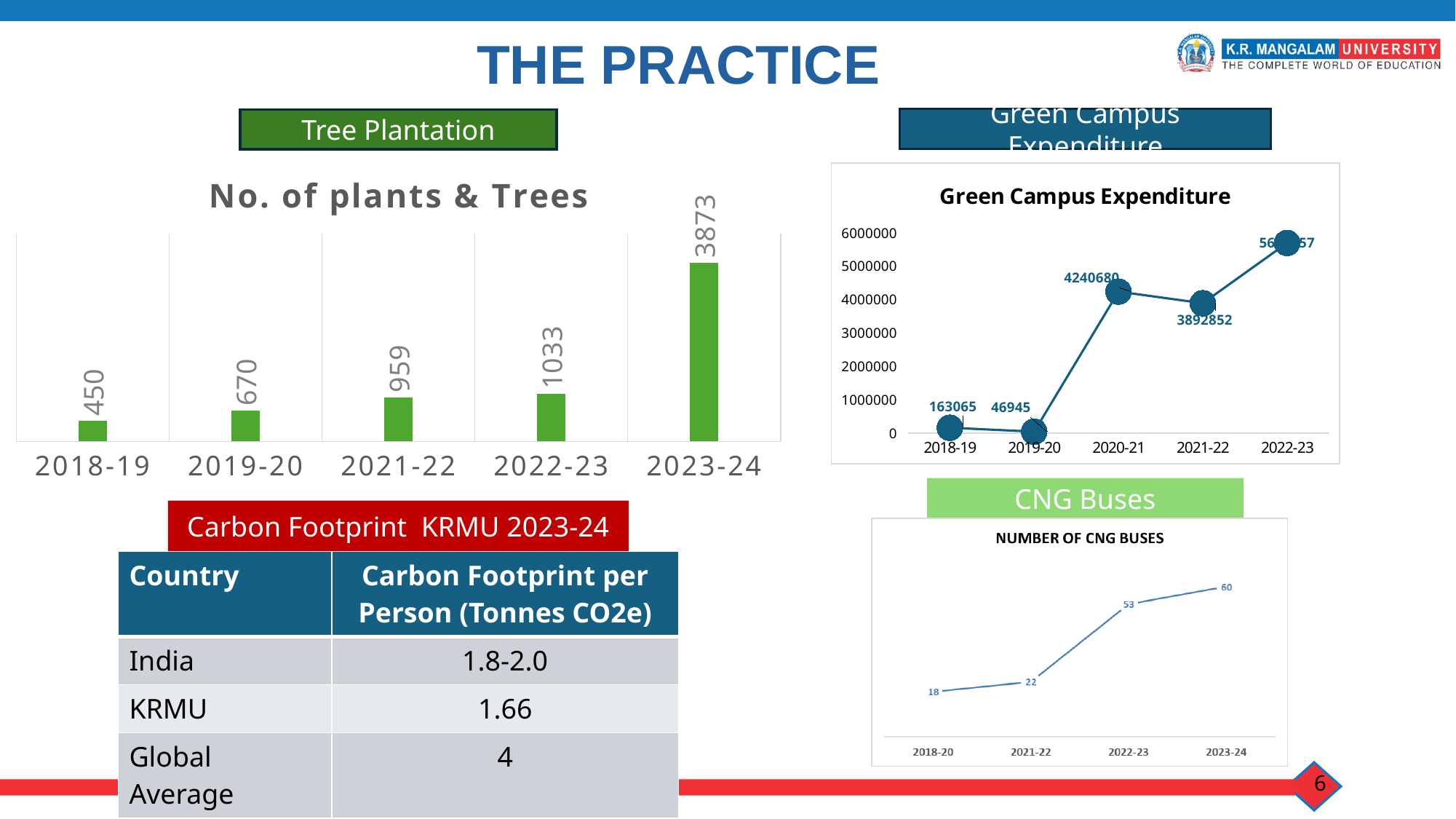
In the 'Green Campus Expenditure' chart, is the value for 2022-23 greater or less than 5000000? greater In the 'Green Campus Expenditure' chart, what is the value for 2020-21? 4240680 In the 'Green Campus Expenditure' chart, what is the value for 2019-20? 46945 In the 'NUMBER OF CNG BUSES' chart, what is the difference between the values for 2023-24 and 2018-20? 42 In the 'Green Campus Expenditure' chart, which is larger, the value for 2020-21 or 2021-22? 2020-21 In the 'No. of plants & Trees' chart, what is the value for 2023-24? 3873 In the 'NUMBER OF CNG BUSES' chart, what is the value for 2022-23? 53 How many years are shown in the 'No. of plants & Trees' chart? 5 In the 'No. of plants & Trees' chart, which year has the lowest value? 2018-19 In the 'NUMBER OF CNG BUSES' chart, do the values rise or fall from 2018-20 to 2023-24? rise In the 'No. of plants & Trees' chart, what is the difference between the values for 2022-23 and 2021-22? 74 What kind of chart is the 'No. of plants & Trees' chart? bar chart